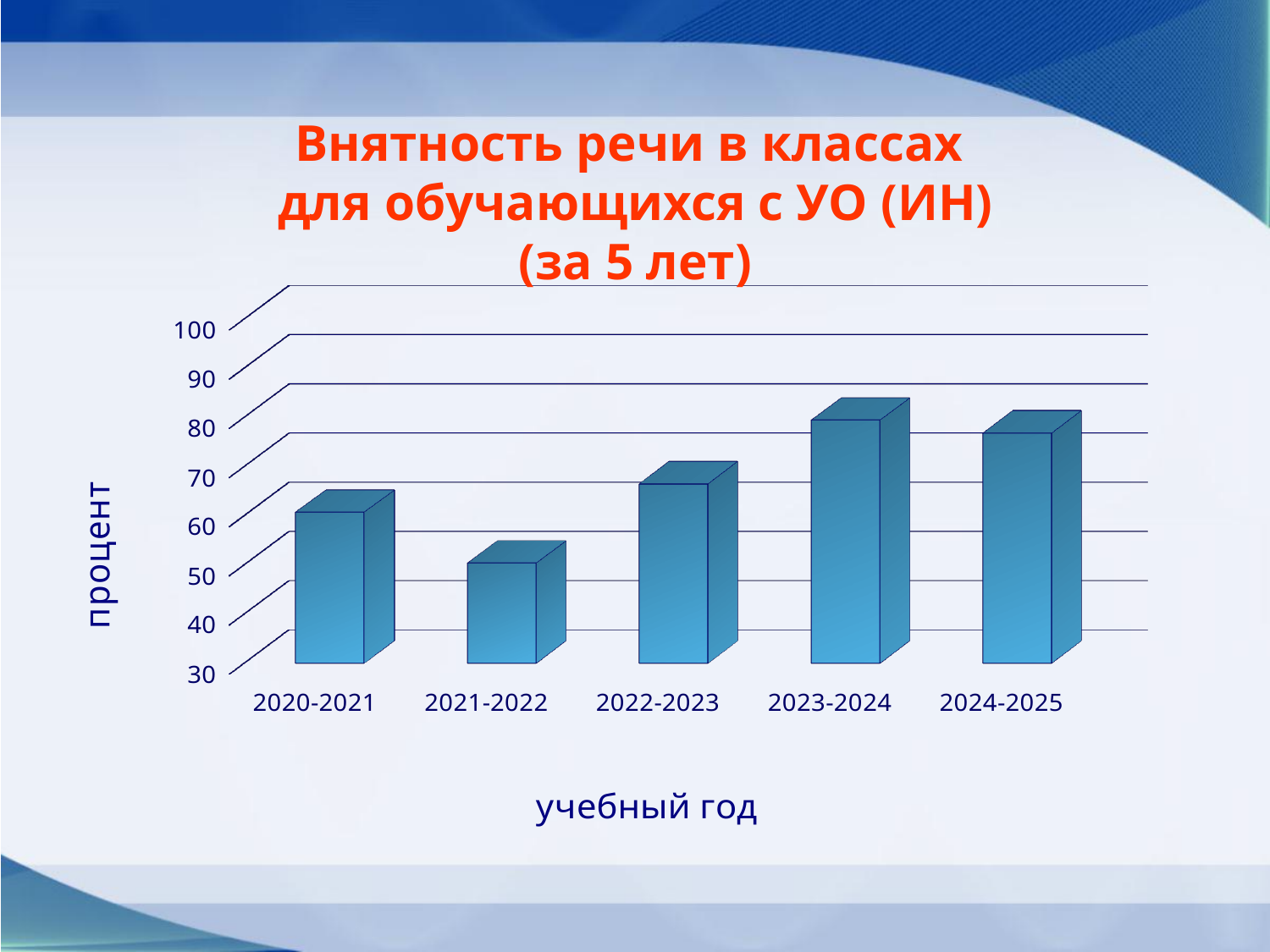
How many academic years (categories) are shown on the x axis? 5 Is the value for 2023-2024 greater or less than 70? greater Is the value for 2024-2025 greater or less than 90? less Which academic year has the highest value? 2023-2024 Is the value for 2020-2021 greater or less than 50? greater Do the values rise or fall from 2021-2022 to 2023-2024? rise Which academic year has the lowest value? 2021-2022 What is the label of the horizontal axis? учебный год What kind of chart is shown on the slide? bar chart What is the label of the vertical axis? процент Which is larger, the value for 2021-2022 or the value for 2022-2023? 2022-2023